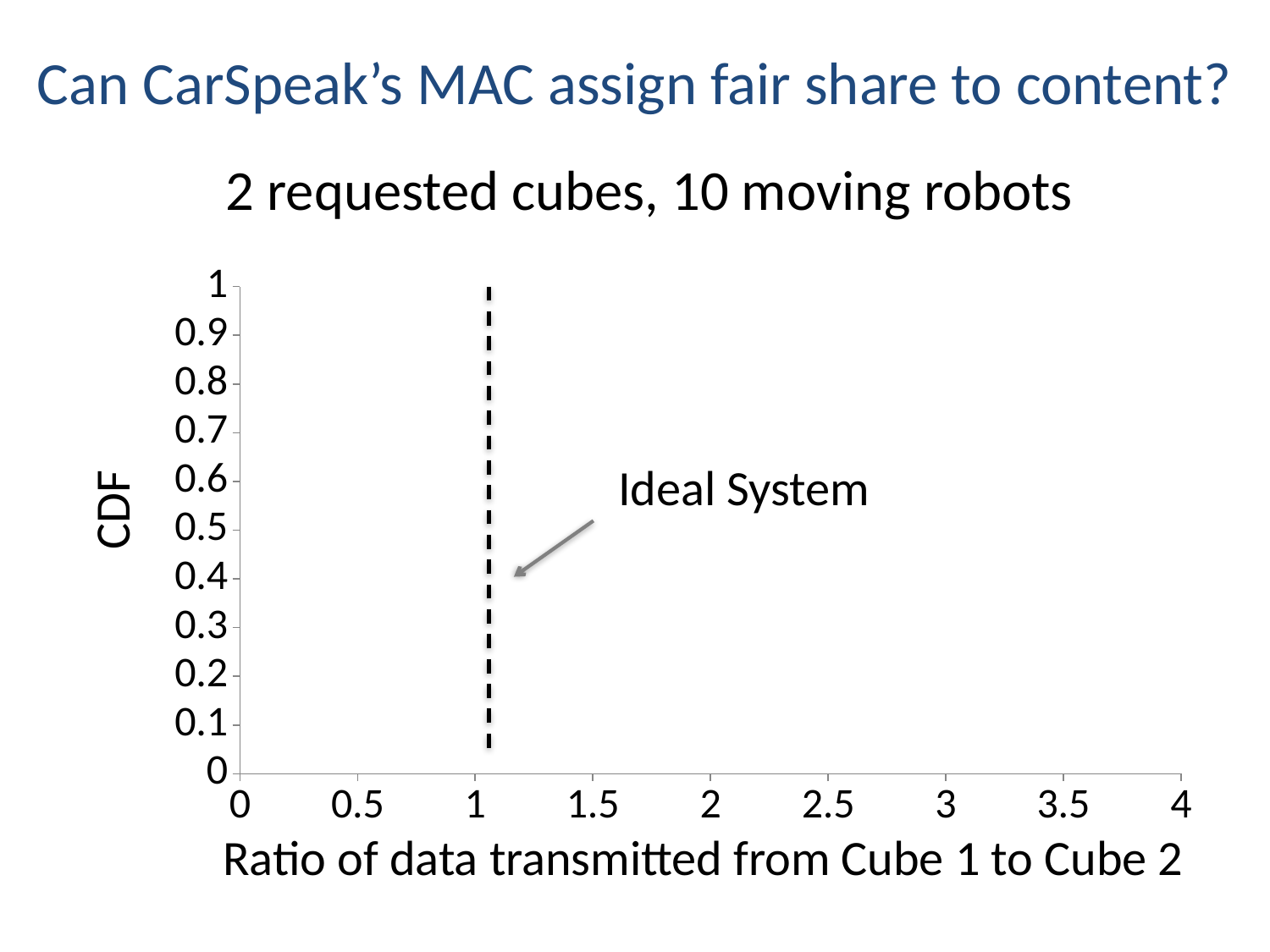
Is the ratio at which the Ideal System dashed line is drawn greater or less than 0.5? greater What does the dashed vertical line on the chart represent? Ideal System Is the ratio at which the Ideal System dashed line is drawn greater or less than 2? less What is the label of the x axis of the chart? Ratio of data transmitted from Cube 1 to Cube 2